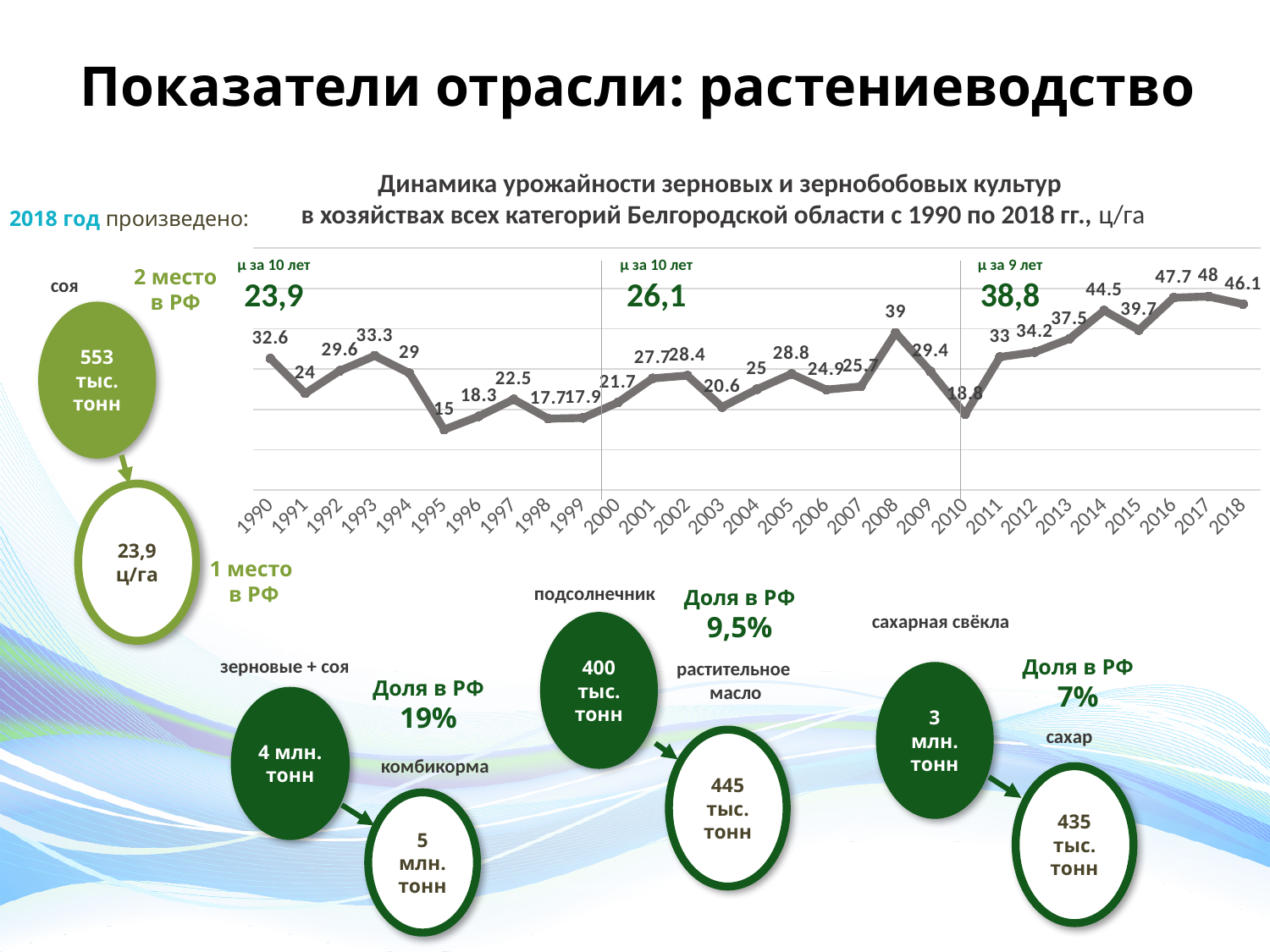
Which year has the highest value on the chart? 2017 What is the grain yield value for 2018 on the chart? 46.1 What type of chart is shown on the slide? line chart What is the average value shown for the last 9-year period (μ за 9 лет)? 38,8 What is the grain yield value for 1990 on the chart? 32.6 Which year has the lowest value on the chart? 1995 Which year has the larger value, 2014 or 2015? 2014 What is the difference between the values for 2018 and 1990? 13.5 Overall, do the values rise or fall from 1990 to 2018? rise What is the value plotted for 2008? 39 What is the difference between the values for 2008 and 2010? 20.2 How many years (data points) are plotted on the chart? 29